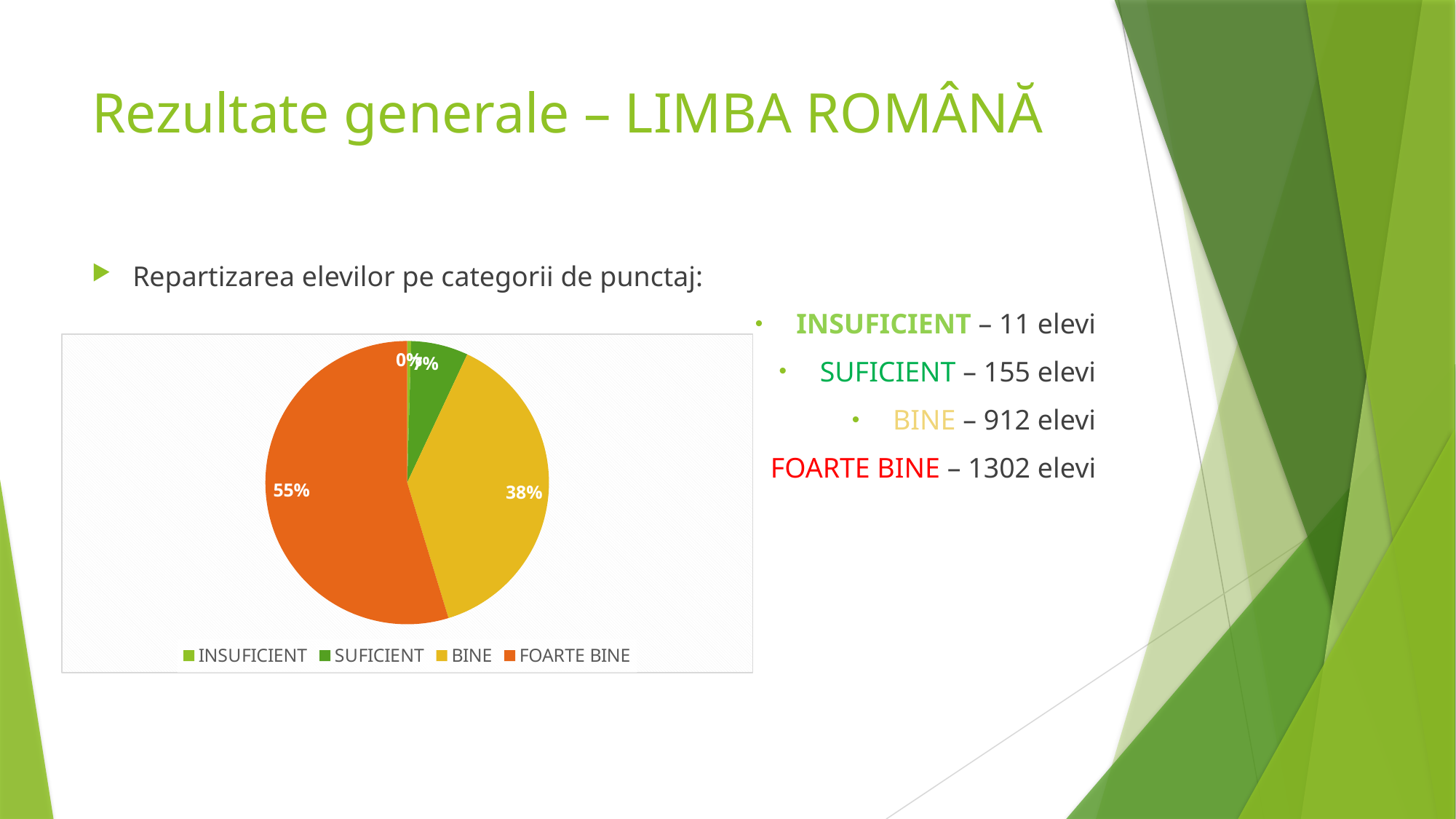
What percentage of the pie does BINE represent? 38% What percentage of the pie does FOARTE BINE represent? 55% Which slice is larger, SUFICIENT or BINE? BINE Which category has the smallest slice of the pie chart? INSUFICIENT What percentage is shown for INSUFICIENT in the pie chart? 0% What are the legend entries of the pie chart, in order? INSUFICIENT, SUFICIENT, BINE, FOARTE BINE What is the difference in percentage points between the FOARTE BINE and BINE slices? 17 percentage points How many categories are shown in the pie chart? 4 Which category has the largest slice of the pie chart? FOARTE BINE What colour is the FOARTE BINE slice in the pie chart? orange Which slice is larger, BINE or FOARTE BINE? FOARTE BINE What kind of chart is shown on the slide? pie chart